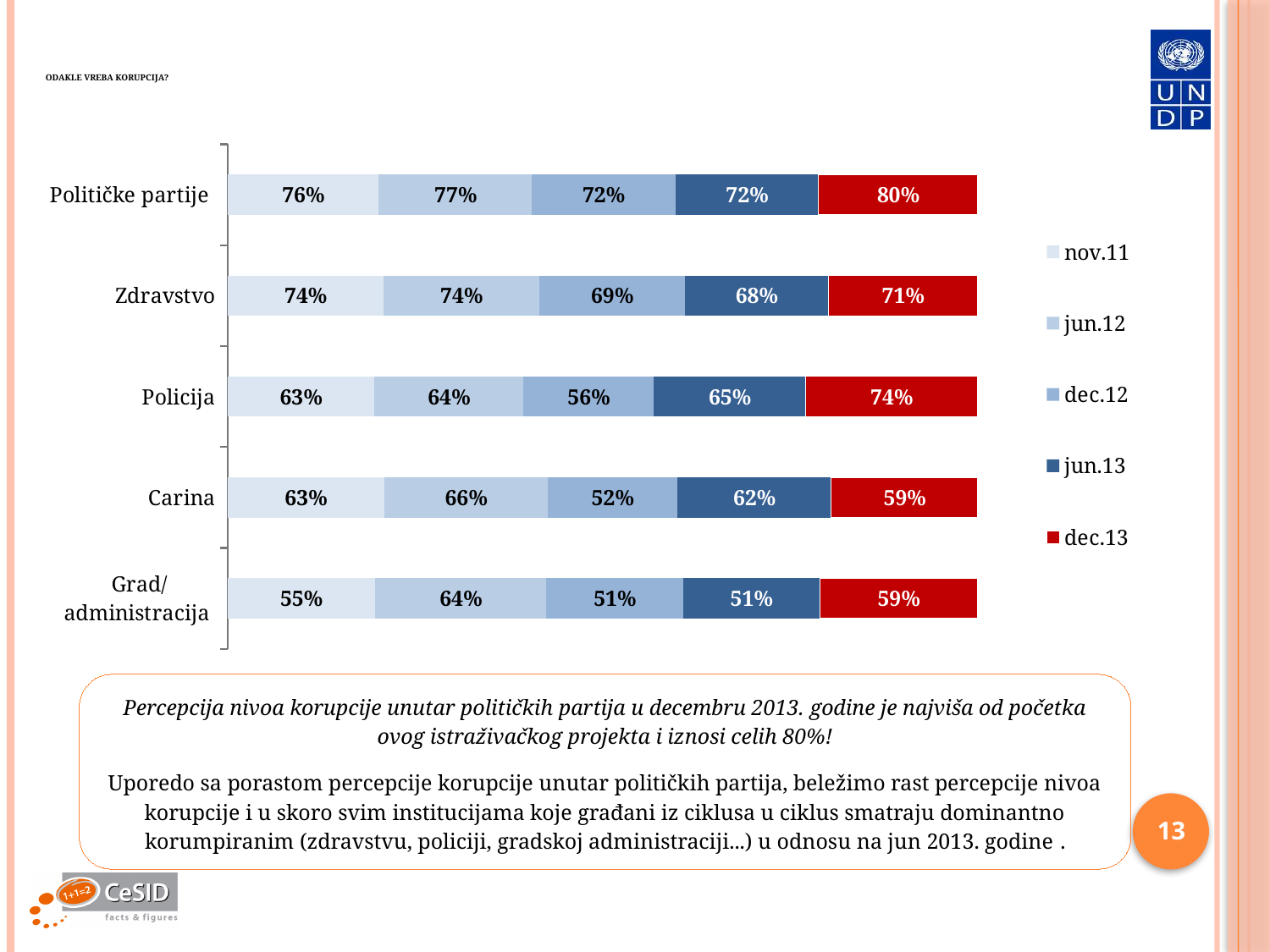
What is the dec.13 value for Političke partije? 80% What is the total of the stacked bar for Grad/administracija? 280% Which is larger for Zdravstvo: the nov.11 value or the dec.13 value? nov.11 What is the difference between the dec.13 and jun.13 values for Policija? 9% What is the dec.12 value for Carina? 52% How many categories are shown on the y axis? 5 What is the nov.11 value for Grad/administracija? 55% What is the jun.13 value for Policija? 65% Which category has the highest dec.13 value? Političke partije How many series does the legend list? 5 What kind of chart is shown on the slide? Stacked bar chart Which category has the lowest dec.12 value? Grad/administracija